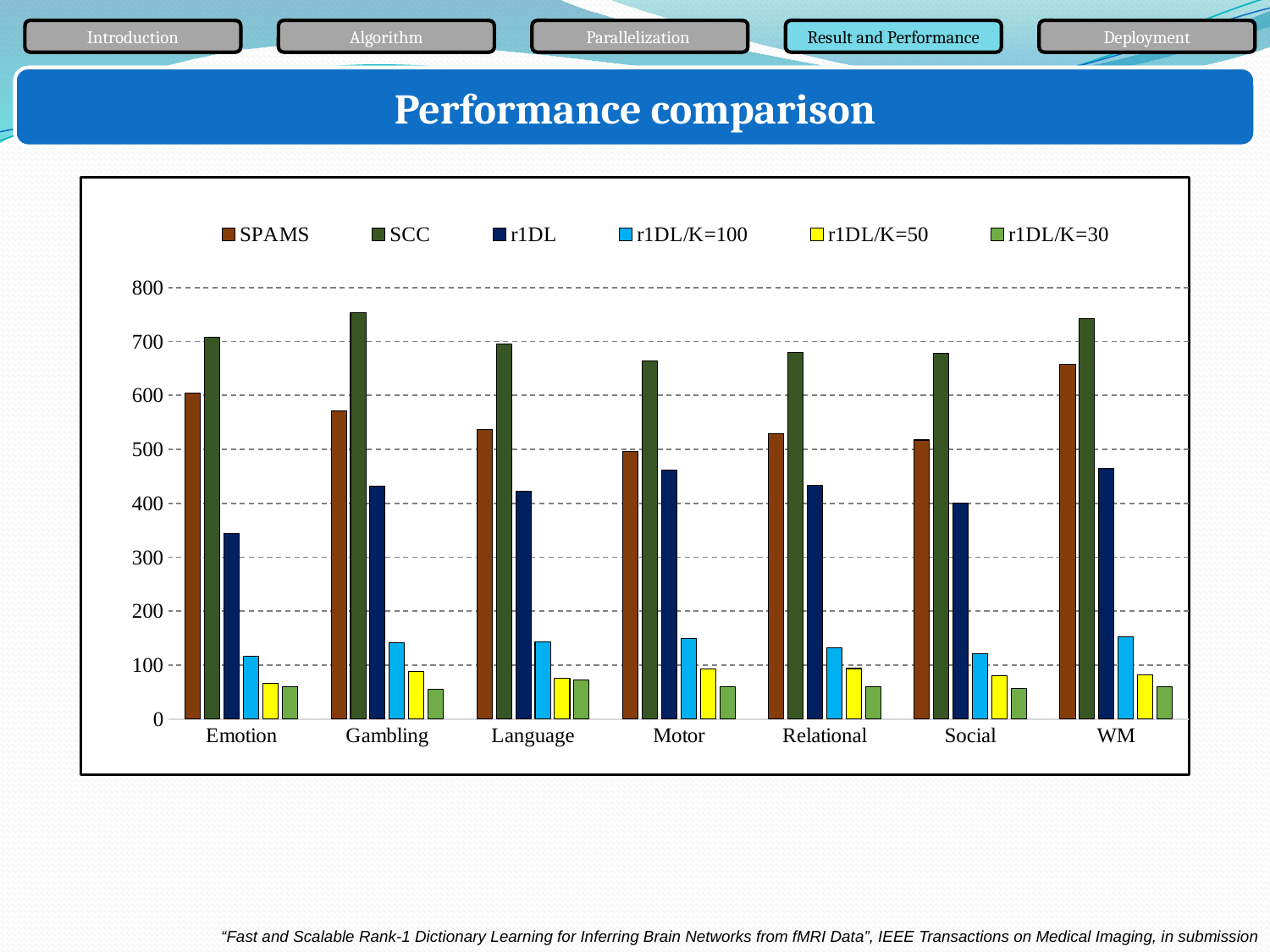
Which is larger: the SCC value for Gambling or the SCC value for Motor? Gambling What is the title of the chart on the slide? Performance comparison Which series has the highest value for Emotion? SCC How many series does the chart's legend list? 6 For Emotion, which is larger: the SPAMS value or the r1DL value? SPAMS Which series has the lowest value for Gambling? r1DL/K=30 Which category has the highest SPAMS value? WM Is the r1DL/K=100 value for WM greater or less than 100? greater Is the r1DL value for Emotion greater or less than 400? less Is the SCC value for Gambling greater or less than 700? greater What kind of chart is shown on the slide? bar chart How many categories are shown on the x axis of the chart? 7